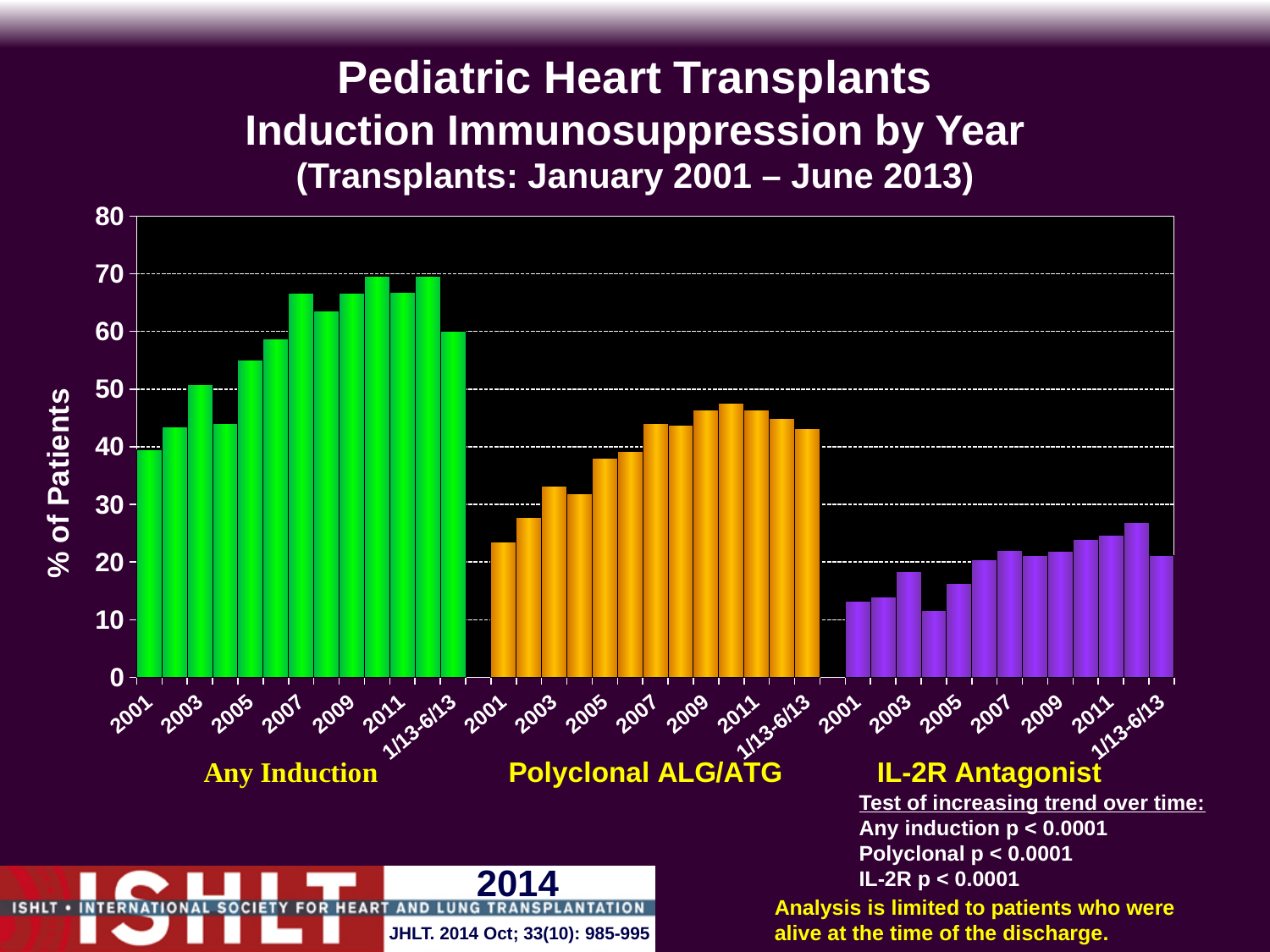
Which year has the lowest value in the Any Induction group? 2001 Which year has the lowest value in the IL-2R Antagonist group? 2004 Which is larger: the Any Induction value for 2007 or the Any Induction value for 2001? 2007 Which year has the highest value in the IL-2R Antagonist group? 2012 What kind of chart is shown on the slide? bar chart Is the value for Polyclonal ALG/ATG in 2010 greater or less than 40? greater Which year has the lowest value in the Polyclonal ALG/ATG group? 2001 Is the value for IL-2R Antagonist in 2012 greater or less than 20? greater Do the Polyclonal ALG/ATG values generally rise or fall from 2001 to 2010? rise How many bars are plotted in the Any Induction group? 13 What is the label of the y axis? % of Patients